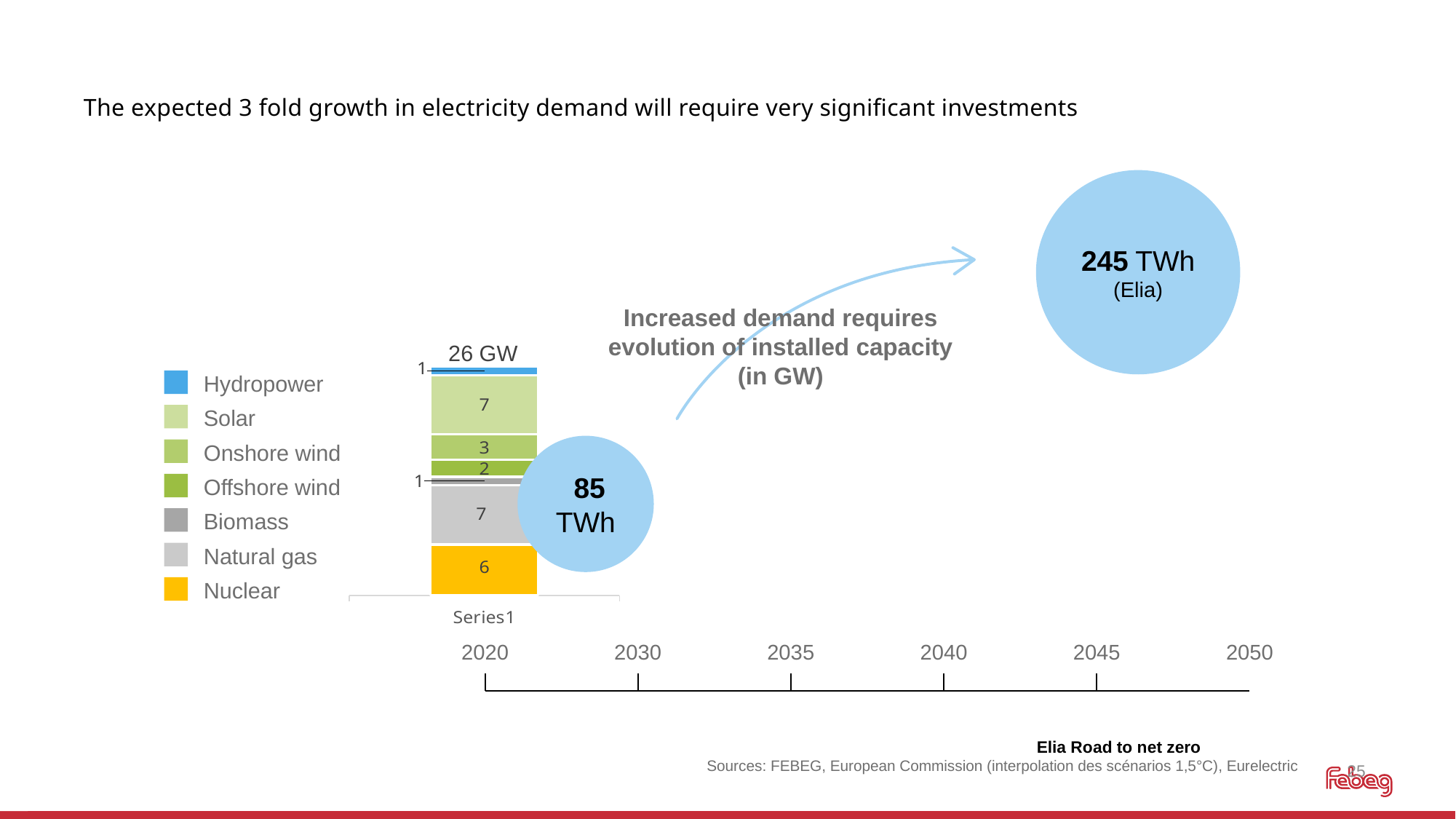
What is the value for Nuclear in the stacked bar? 6 Which colour represents Nuclear in the legend? yellow Which is larger in the stacked bar, Nuclear or Onshore wind? Nuclear What kind of chart is shown on the slide? stacked bar chart What is the difference between the Solar value and the Offshore wind value in the stacked bar? 5 What is the value for Hydropower in the stacked bar? 1 How many series does the legend of the stacked bar chart list? 7 What is the value for Solar in the stacked bar? 7 What is the value for Onshore wind in the stacked bar? 3 What total is printed above the stacked bar? 26 GW What is the value for Natural gas in the stacked bar? 7 What is the value for Offshore wind in the stacked bar? 2